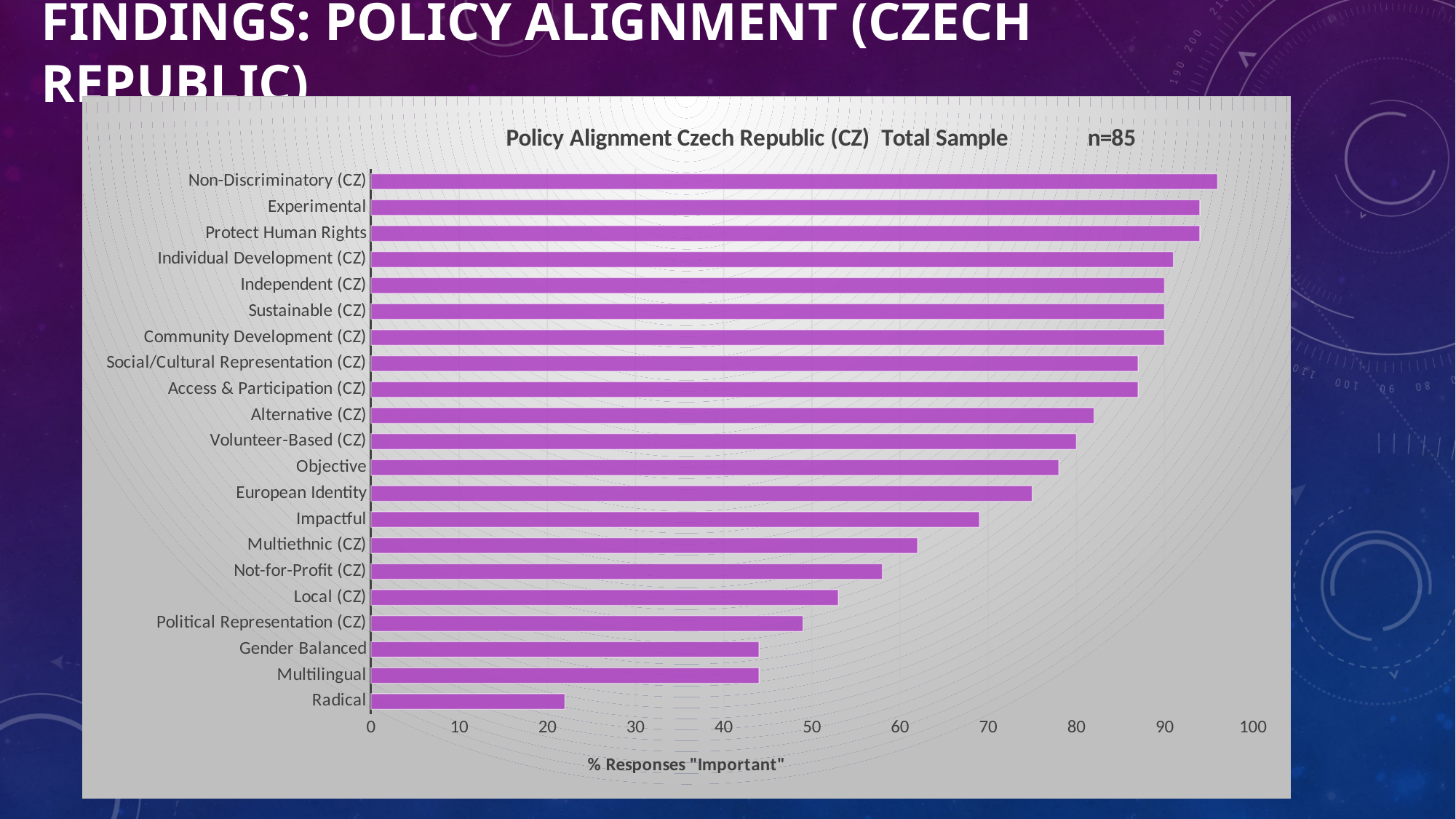
What kind of chart is shown on the slide? Bar chart Is the value for Gender Balanced greater or less than 40? greater Is the value for Not-for-Profit (CZ) greater or less than 60? less Is the value for Radical greater or less than 30? less What is the sample size (n) stated in the chart title? n=85 Which category has the lowest value in the chart? Radical Which has a larger value, Local (CZ) or Multilingual? Local (CZ) What is the label on the horizontal axis of the chart? % Responses "Important" How many categories are plotted in the chart? 21 Which category has the highest value in the chart? Non-Discriminatory (CZ)